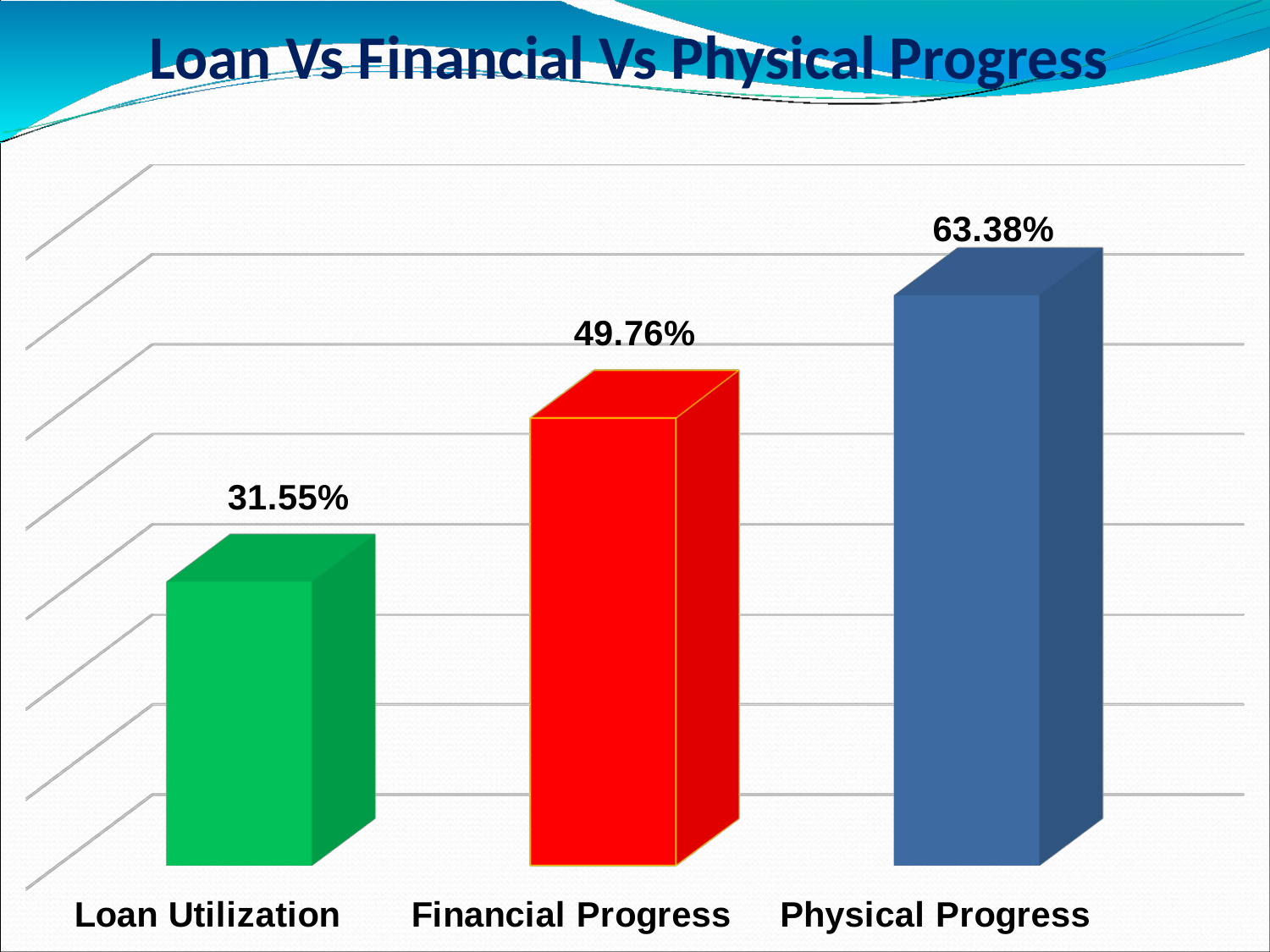
What is the difference between Physical Progress and Loan Utilization? 31.83% What is the value for Loan Utilization? 31.55% Do the values rise or fall from left to right across the categories? Rise How many categories are shown in the chart? 3 Which category has the lowest value? Loan Utilization Which is larger, Financial Progress or Physical Progress? Physical Progress Which category has the highest value? Physical Progress What is the difference between Financial Progress and Loan Utilization? 18.21% What is the value for Financial Progress? 49.76% What is the title of the slide? Loan Vs Financial Vs Physical Progress What is the value for Physical Progress? 63.38% What kind of chart is shown on the slide? Bar chart